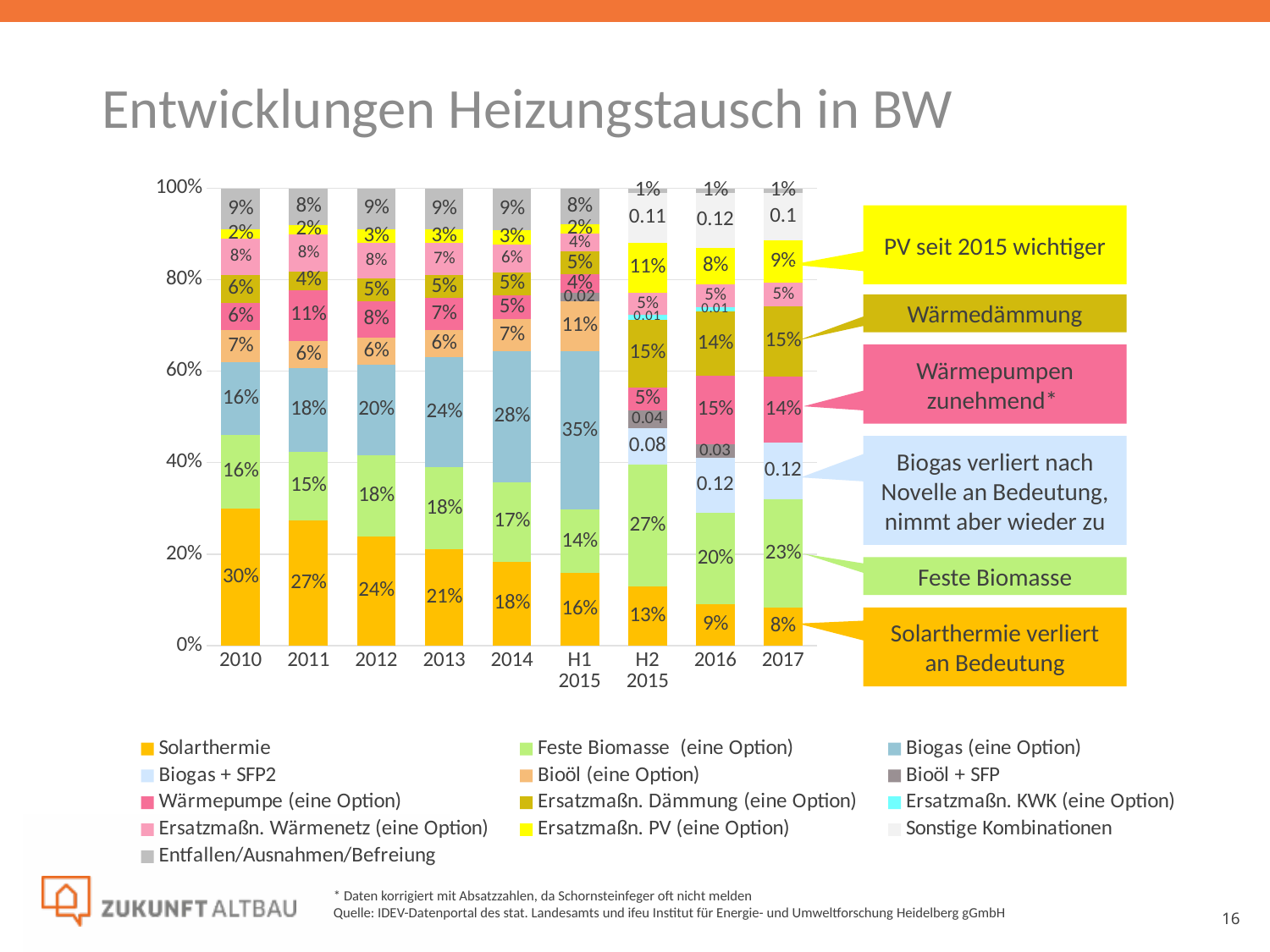
What is the share of Feste Biomasse (eine Option) in H2 2015? 27% What is the share of Biogas (eine Option) in 2014? 28% How many series does the chart's legend list? 13 By how many percentage points does the Solarthermie share differ between 2010 and 2017? 22 percentage points In which year is the Solarthermie share highest? 2010 Does the Solarthermie share rise or fall from 2010 to 2017? Fall How many time periods are shown along the x axis of the chart? 9 What is the share of Ersatzmaßn. PV (eine Option) in H2 2015? 11% What kind of chart is shown on the slide? Stacked bar chart Which year has the larger Wärmepumpe (eine Option) share, 2011 or 2016? 2016 What is the share of Solarthermie in 2010? 30% What is the share of Solarthermie in 2017? 8%